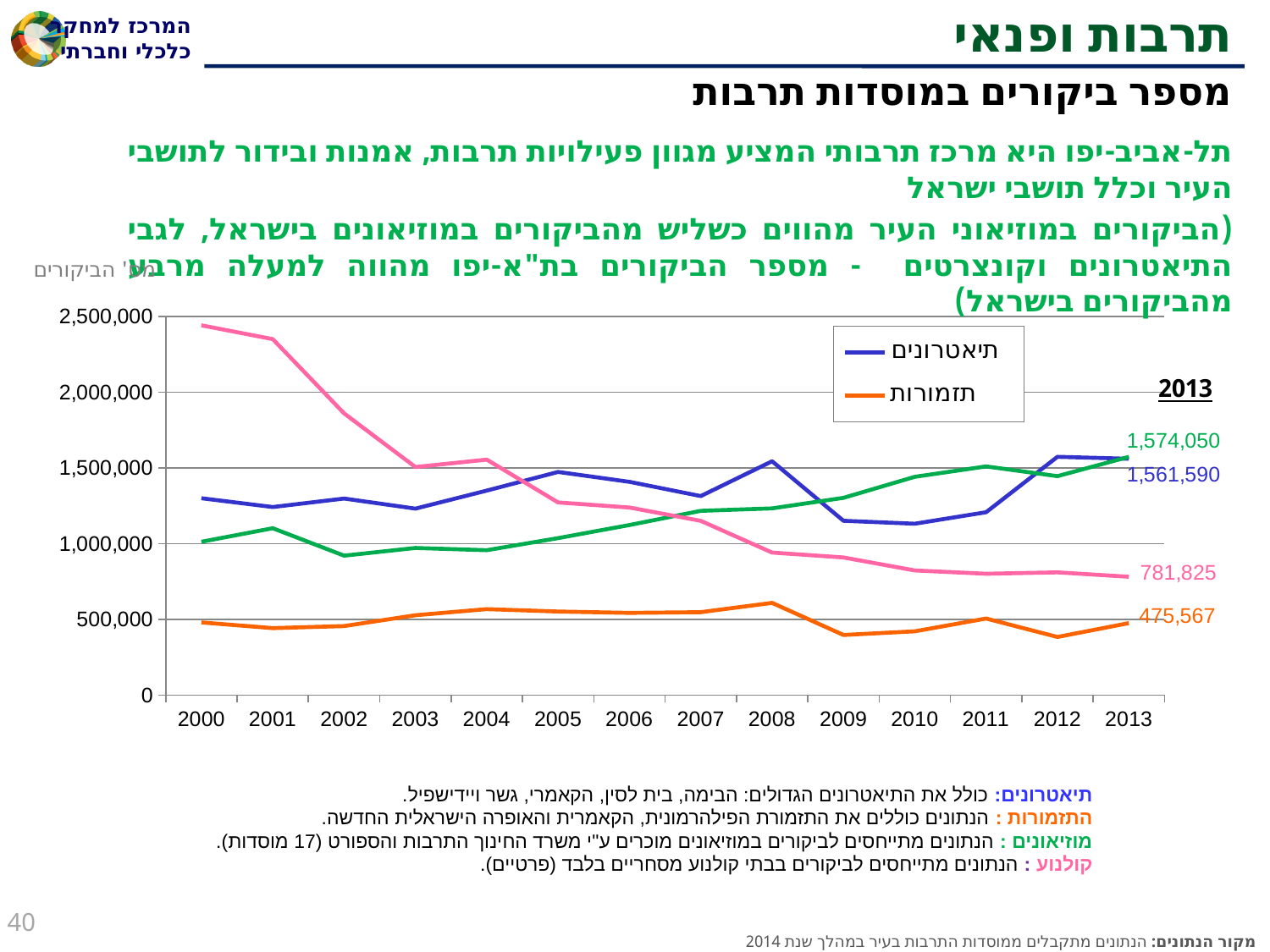
How many years are plotted along the x axis of the chart? 14 Does the pink line rise or fall overall from 2000 to 2013? fall What is the difference between the 2013 values of the pink line (781,825) and the orange תזמורות line (475,567)? 306,258 Is the value of the pink line in 2000 greater or less than 2,000,000? greater Which of the four lines has the lowest labelled value in 2013? תזמורות (475,567) In 2013, which is larger: the value for תיאטרונים or the value for תזמורות? תיאטרונים What is the 2013 value for תיאטרונים (the blue line)? 1,561,590 What is the 2013 value labelled on the green line? 1,574,050 What is the difference between the 2013 values of the green line (1,574,050) and the blue תיאטרונים line (1,561,590)? 12,460 How many series does the chart's legend list? 2 What kind of chart is shown on the slide? line chart What is the 2013 value for תזמורות (the orange line)? 475,567